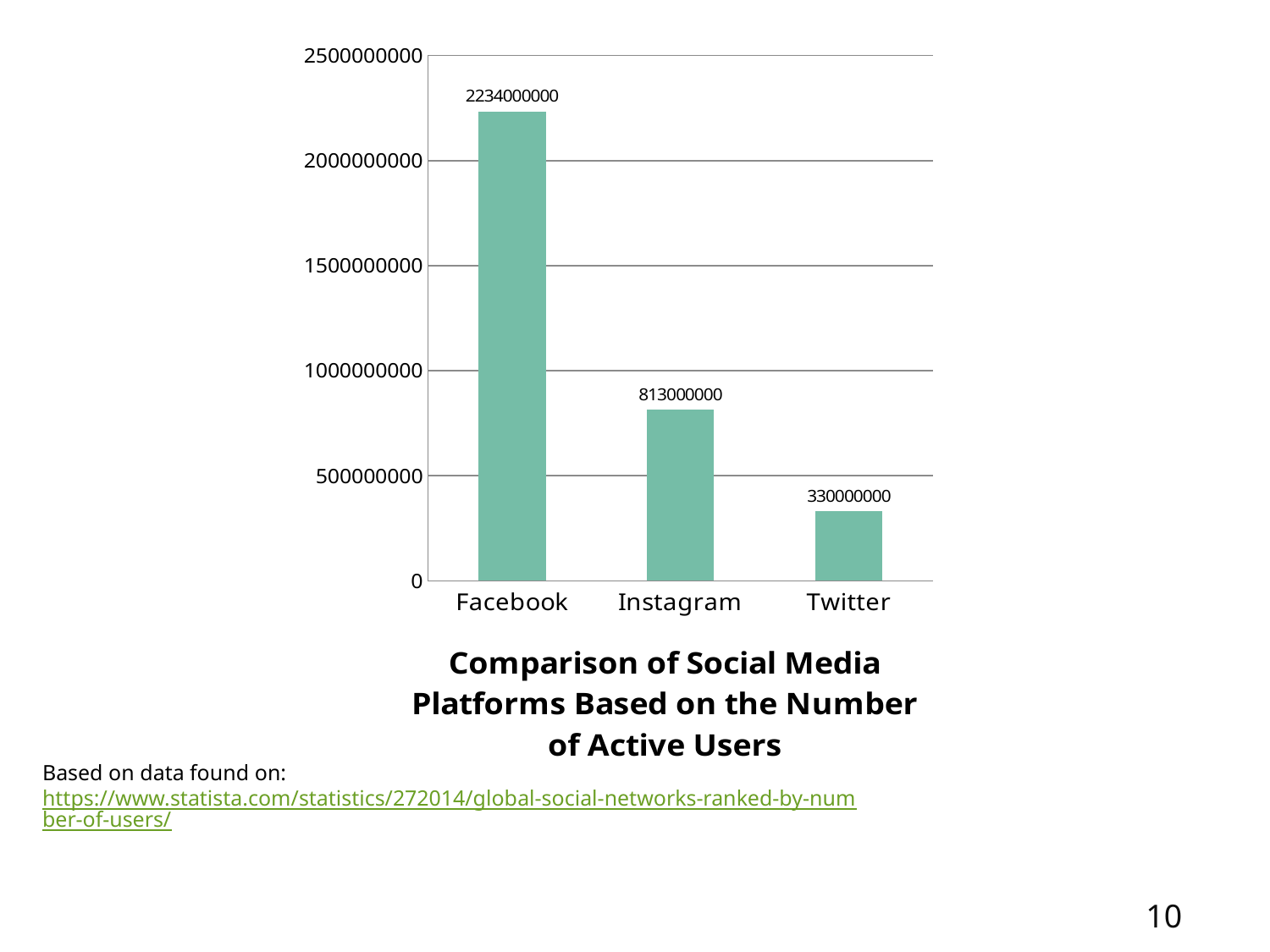
What is the difference in active users between Facebook and Instagram? 1421000000 What is the number of active users for Instagram? 813000000 Which platform has the highest number of active users? Facebook What is the number of active users for Twitter? 330000000 What kind of chart is shown on the slide? Bar chart How many platforms are shown in the chart? 3 Which has more active users, Instagram or Twitter? Instagram Which platform has the lowest number of active users? Twitter Is the value for Instagram greater or less than 1000000000? less What is the number of active users for Facebook? 2234000000 What is the difference in active users between Instagram and Twitter? 483000000 What is the title of the chart? Comparison of Social Media Platforms Based on the Number of Active Users